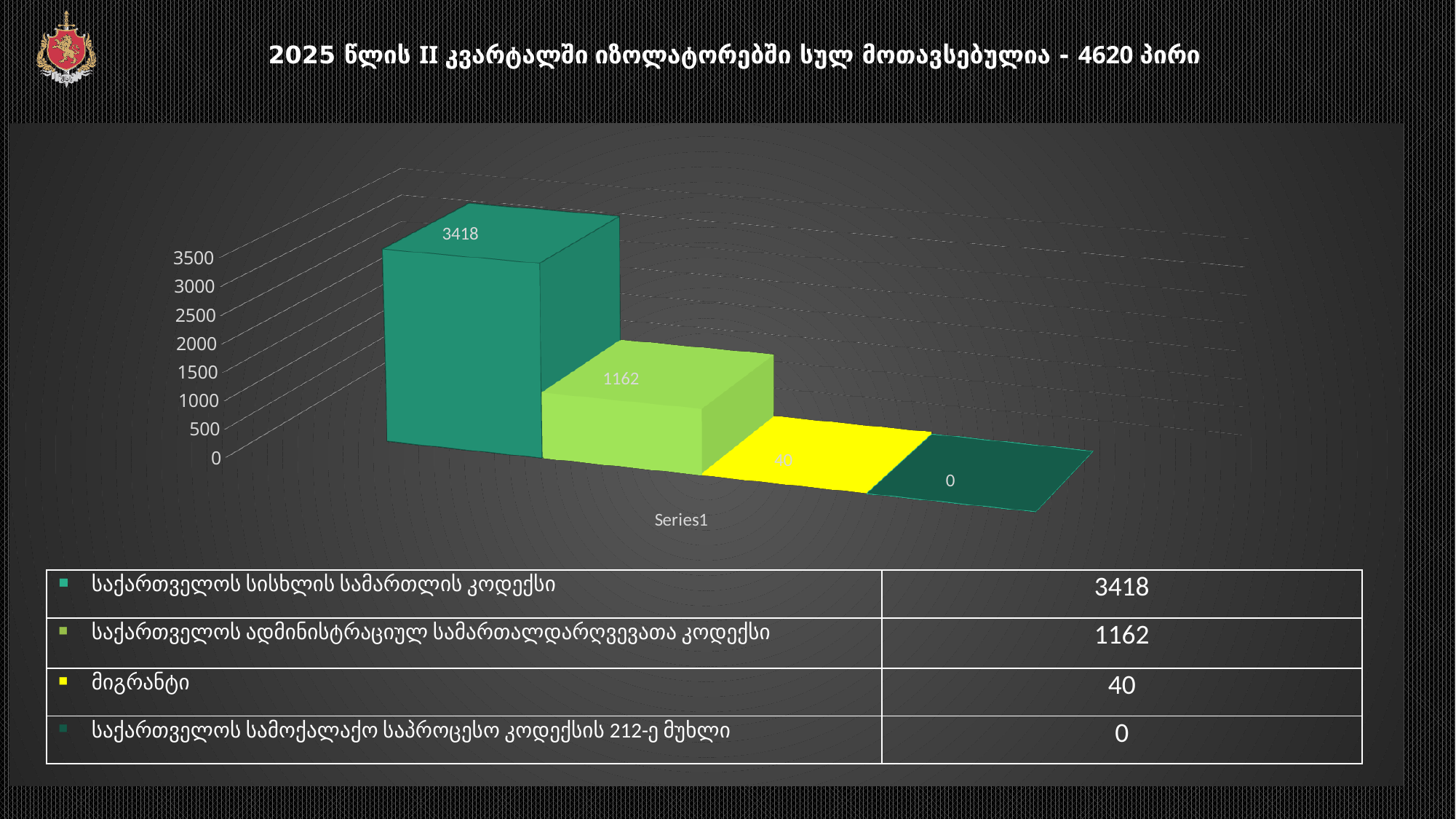
Which is larger, the value for მიგრანტი or the value for საქართველოს ადმინისტრაციულ სამართალდარღვევათა კოდექსი? საქართველოს ადმინისტრაციულ სამართალდარღვევათა კოდექსი What is the value for საქართველოს სისხლის სამართლის კოდექსი? 3418 What is the total of all four values shown in the chart? 4620 Which category has the lowest value? საქართველოს სამოქალაქო საპროცესო კოდექსის 212-ე მუხლი What is the difference between the values for საქართველოს სისხლის სამართლის კოდექსი and საქართველოს ადმინისტრაციულ სამართალდარღვევათა კოდექსი? 2256 What kind of chart is shown on the slide? bar chart What is the value for მიგრანტი? 40 How many bars are plotted in the chart? 4 What is the value for საქართველოს სამოქალაქო საპროცესო კოდექსის 212-ე მუხლი? 0 What is the value for საქართველოს ადმინისტრაციულ სამართალდარღვევათა კოდექსი? 1162 What colour is the bar for მიგრანტი? yellow Which category has the highest value? საქართველოს სისხლის სამართლის კოდექსი